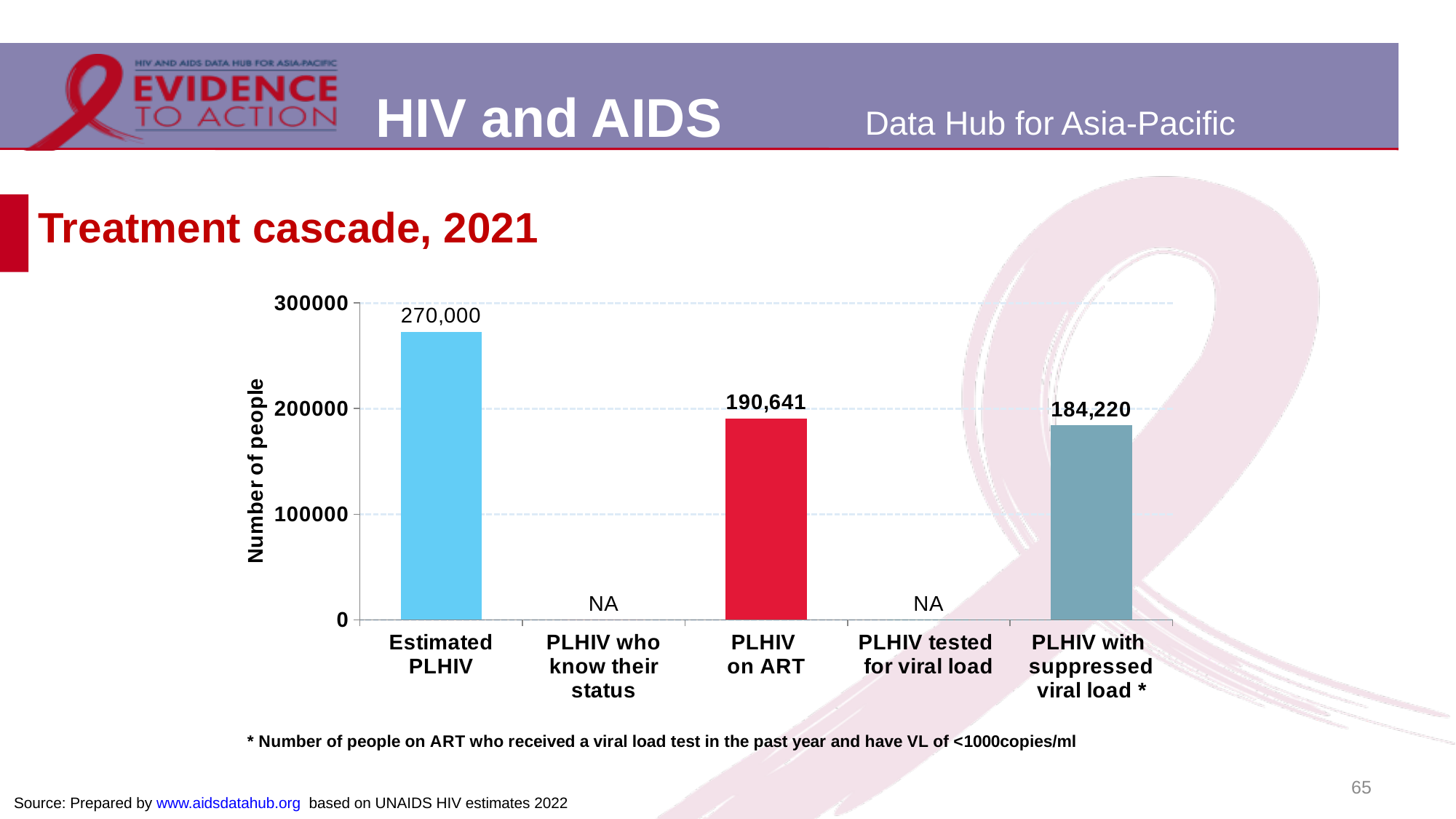
What is the value for Estimated PLHIV? 270,000 What is shown for PLHIV who know their status? NA What is the difference between Estimated PLHIV and PLHIV on ART? 79,359 Which category has the highest value? Estimated PLHIV What is shown for PLHIV tested for viral load? NA What is the title of the chart? Treatment cascade, 2021 What is the value for PLHIV on ART? 190,641 What is the difference between PLHIV on ART and PLHIV with suppressed viral load? 6,421 What is the value for PLHIV with suppressed viral load? 184,220 What kind of chart is this? Bar chart How many categories are shown on the x axis? 5 Which is larger, PLHIV on ART or PLHIV with suppressed viral load? PLHIV on ART